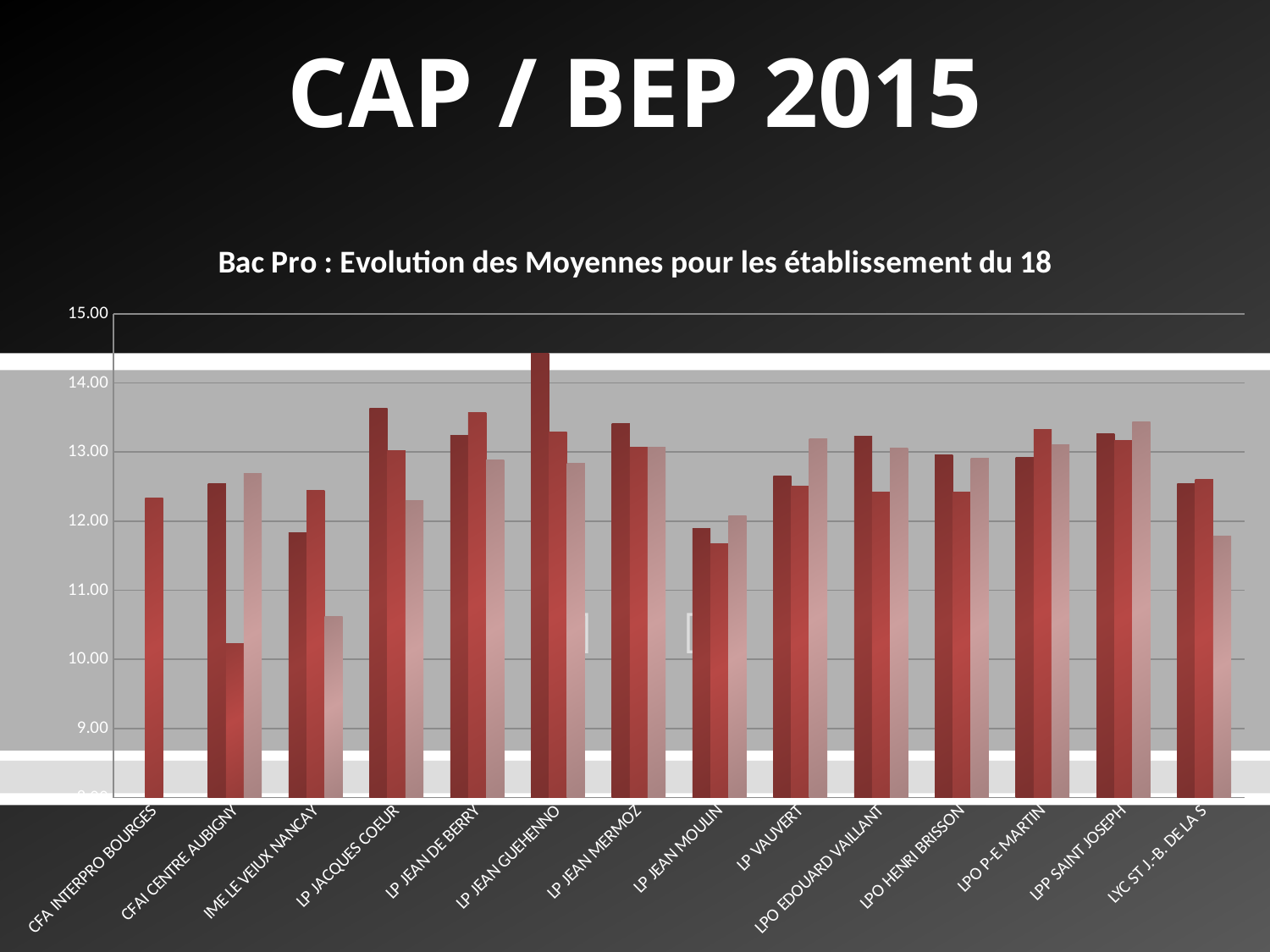
What kind of chart is shown on the slide? bar chart Is the tallest bar for LP JEAN GUEHENNO greater or less than 14.00? greater How many establishments (categories) are shown on the x axis of the chart? 14 What is the highest value shown on the vertical axis of the chart? 15.00 What is the title of the chart? Bac Pro : Evolution des Moyennes pour les établissement du 18 Is the leftmost bar for LP JACQUES COEUR greater or less than 13.00? greater Which establishment has the tallest bar in the chart? LP JEAN GUEHENNO Is the shortest bar for IME LE VIEUX NANCAY greater or less than 11.00? less Which is taller: the tallest bar for LP JEAN GUEHENNO or the tallest bar for LP JEAN MOULIN? LP JEAN GUEHENNO Which establishment has the shortest bar in the chart? CFAI CENTRE AUBIGNY